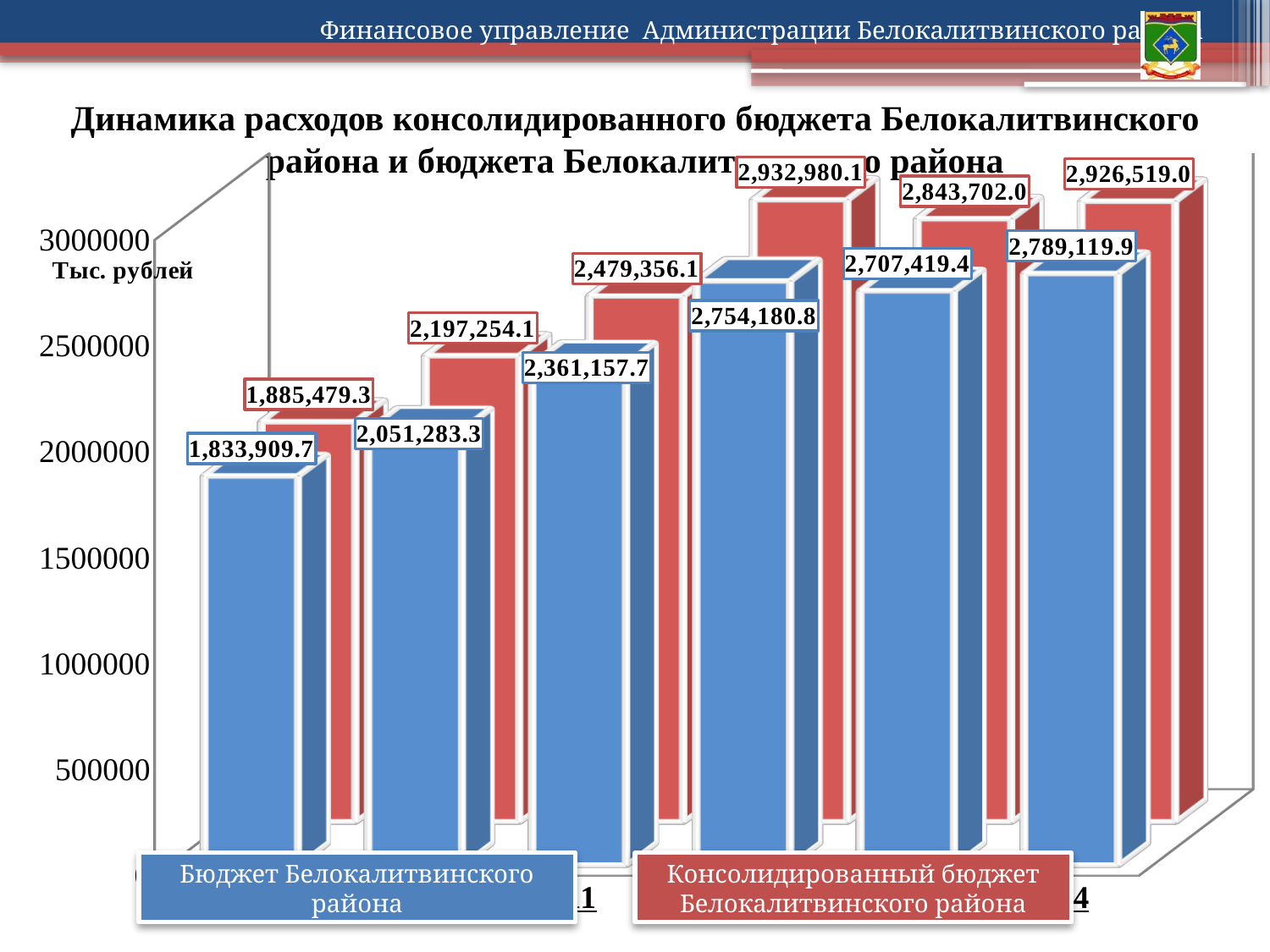
In the rightmost group of bars, what is the difference between the consolidated budget value and the district budget value? 137,399.1 How many series does the legend list? 2 How many groups of bars are plotted in the chart? 6 What is the highest value shown for the series 'Бюджет Белокалитвинского района'? 2,789,119.9 Is the value of the leftmost blue bar ('Бюджет Белокалитвинского района') greater or less than 2000000? less What colour are the bars for the series 'Консолидированный бюджет Белокалитвинского района'? red What is the lowest value shown for the series 'Бюджет Белокалитвинского района'? 1,833,909.7 What kind of chart is shown on the slide? bar chart What is the highest value shown for the series 'Консолидированный бюджет Белокалитвинского района'? 2,932,980.1 Which is larger for the series 'Бюджет Белокалитвинского района': the value 2,754,180.8 in the fourth group or the value 2,707,419.4 in the fifth group? 2,754,180.8 (fourth group) In the leftmost group of bars, what is the difference between the consolidated budget value and the district budget value? 51,569.6 What unit is indicated on the vertical axis of the chart? Тыс. рублей